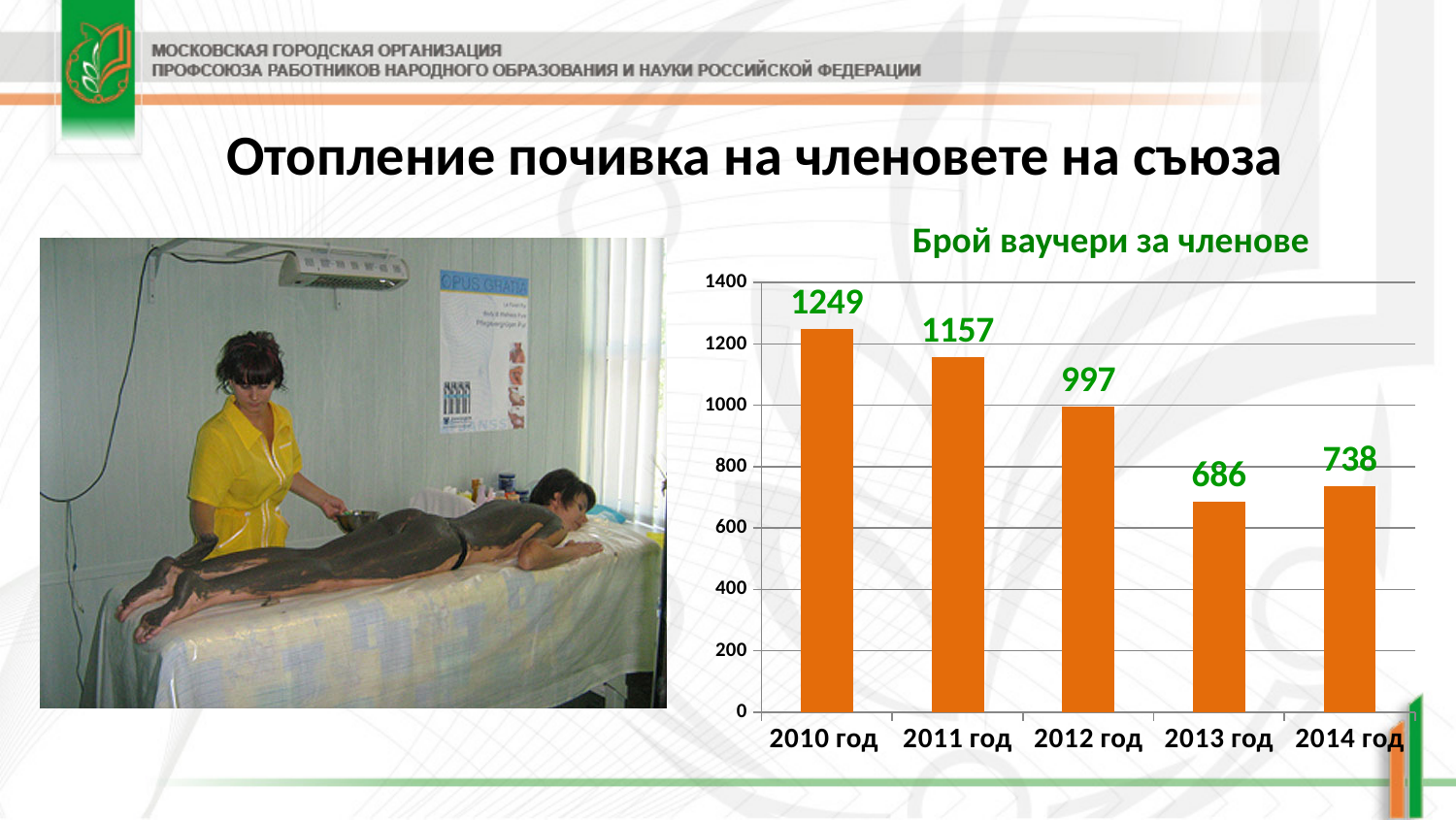
What is the value for 2010 год? 1249 What is the value for 2014 год? 738 What is the value for 2013 год? 686 How many years are shown on the x axis? 5 Which year has the highest value? 2010 год Is the value for 2012 год greater or less than 1000? less What is the title of the chart? Брой ваучери за членове What is the difference between the values for 2010 год and 2011 год? 92 Which is larger, the value for 2012 год or the value for 2014 год? 2012 год What is the difference between the values for 2014 год and 2013 год? 52 Which year has the lowest value? 2013 год What kind of chart is shown on the slide? bar chart